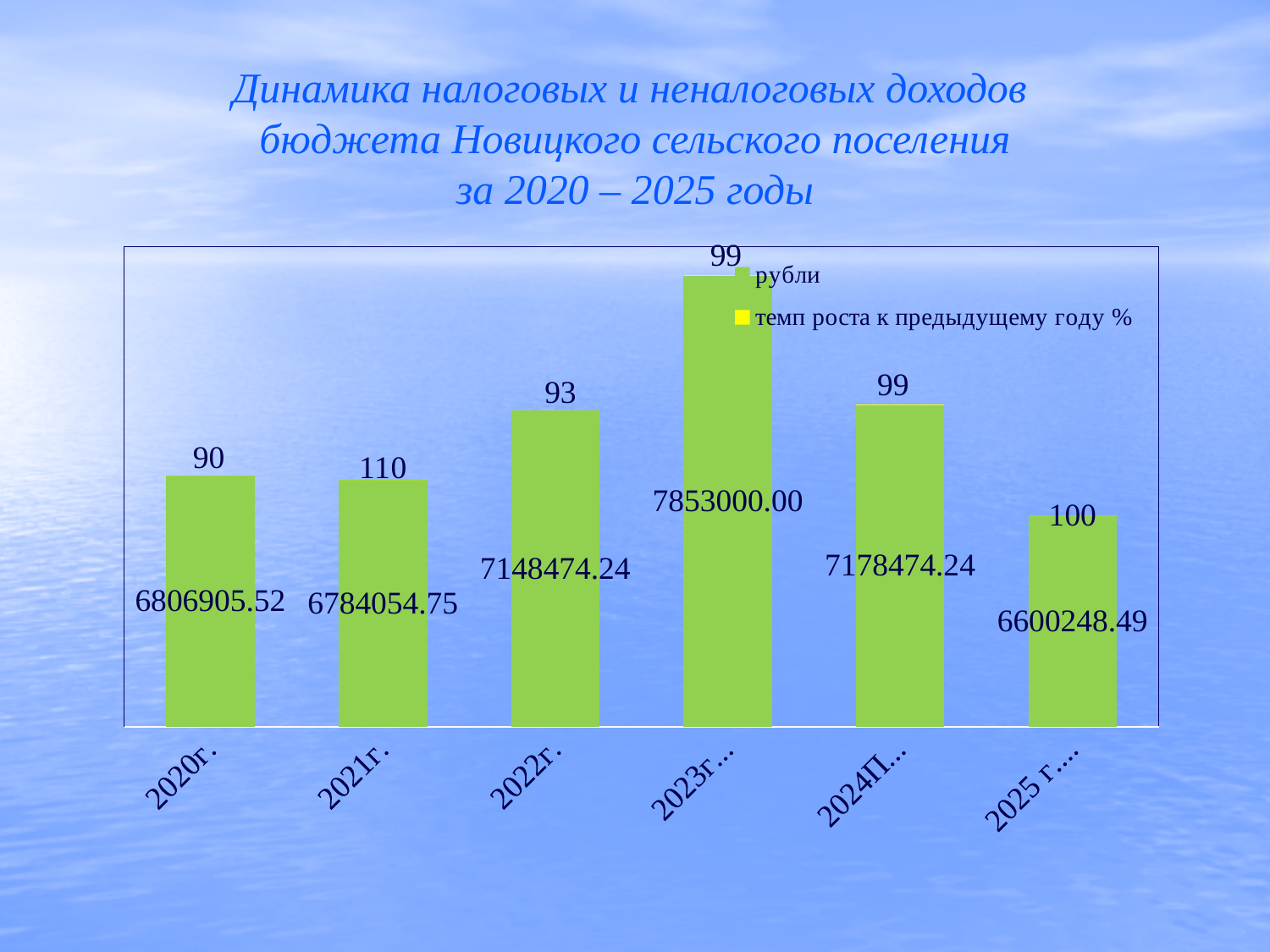
How many series does the legend list? 2 Which is larger, the value in rubles for 2022г. or for 2024? 2024 Which year has the lowest growth rate to the previous year (%)? 2020г. How many years (categories) are shown on the chart? 6 What is the growth rate to the previous year (темп роста к предыдущему году %) shown for 2021г.? 110 Which year has the highest value in rubles? 2023 Do the values in rubles rise or fall from 2023 to 2025? fall What is the value in rubles for 2020г.? 6806905.52 What is the value in rubles for 2023? 7853000.00 What is the value in rubles for 2025? 6600248.49 What is the difference in rubles between 2023 and 2022г.? 704525.76 Which year has the lowest value in rubles? 2025